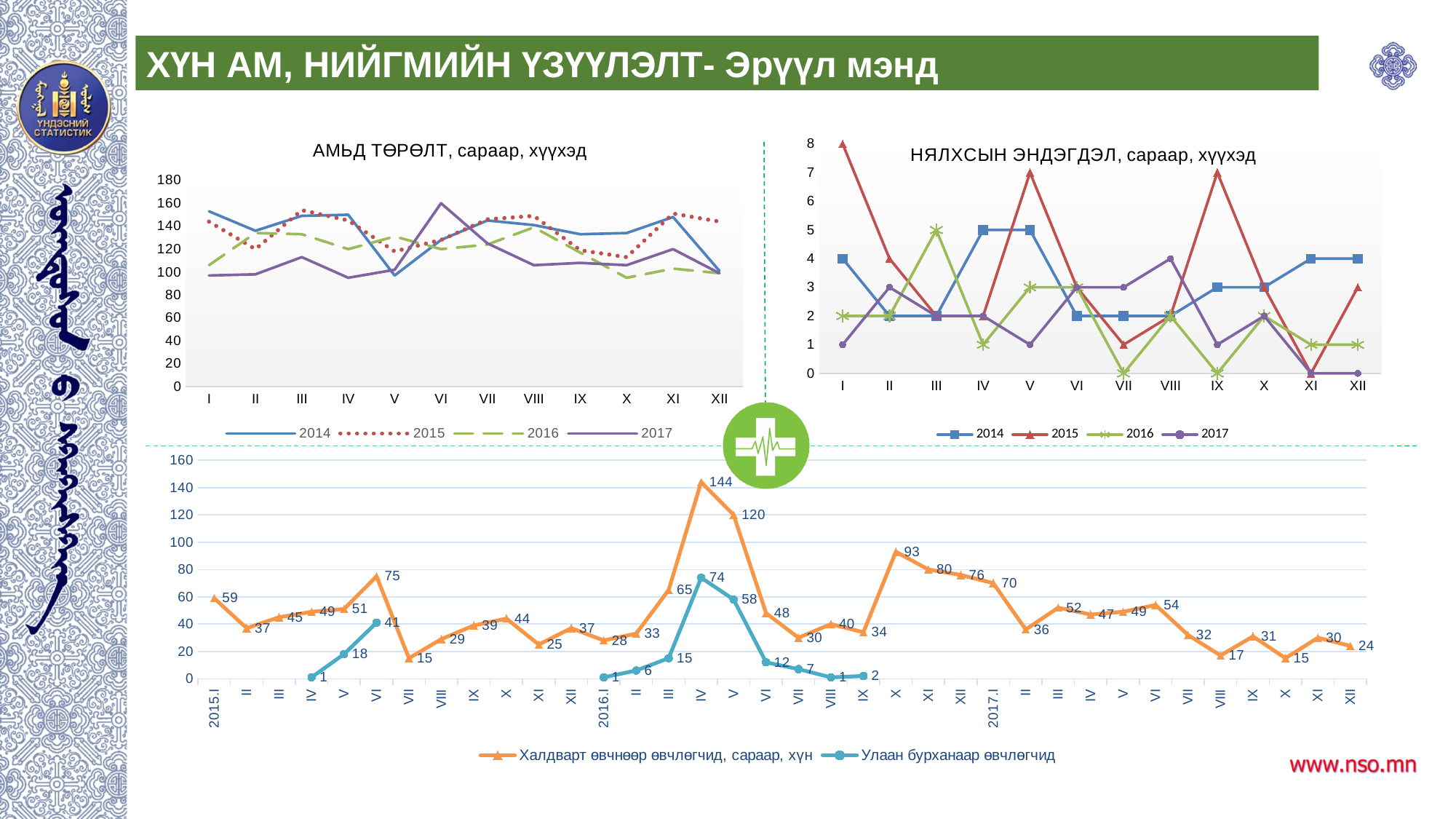
In the bottom chart, what is the value of 'Халдварт өвчнөөр өвчлөгчид, сараар, хүн' for 2017.XII? 24 In the chart titled 'НЯЛХСЫН ЭНДЭГДЭЛ, сараар, хүүхэд', what is the difference between the 2015 and 2014 values in month I? 4 In the chart titled 'НЯЛХСЫН ЭНДЭГДЭЛ, сараар, хүүхэд', what is the value for 2015 in month I? 8 In the chart titled 'НЯЛХСЫН ЭНДЭГДЭЛ, сараар, хүүхэд', in which month is the 2015 value highest? I In the chart titled 'АМЬД ТӨРӨЛТ, сараар, хүүхэд', is the value for 2016 in month XII greater or less than 120? less In the chart titled 'НЯЛХСЫН ЭНДЭГДЭЛ, сараар, хүүхэд', what is the value for 2016 in month III? 5 In the chart titled 'АМЬД ТӨРӨЛТ, сараар, хүүхэд', is the value for 2017 in month VI greater or less than 140? greater In the bottom chart, what is the value of 'Халдварт өвчнөөр өвчлөгчид, сараар, хүн' for 2016.IV? 144 In the chart titled 'АМЬД ТӨРӨЛТ, сараар, хүүхэд', how many series does the legend list? 4 What kind of chart is the bottom chart? Line chart In the bottom chart, at which point does 'Улаан бурханаар өвчлөгчид' reach its highest value? 2016.IV In the bottom chart, what is the difference between the two series at 2016.IV? 70